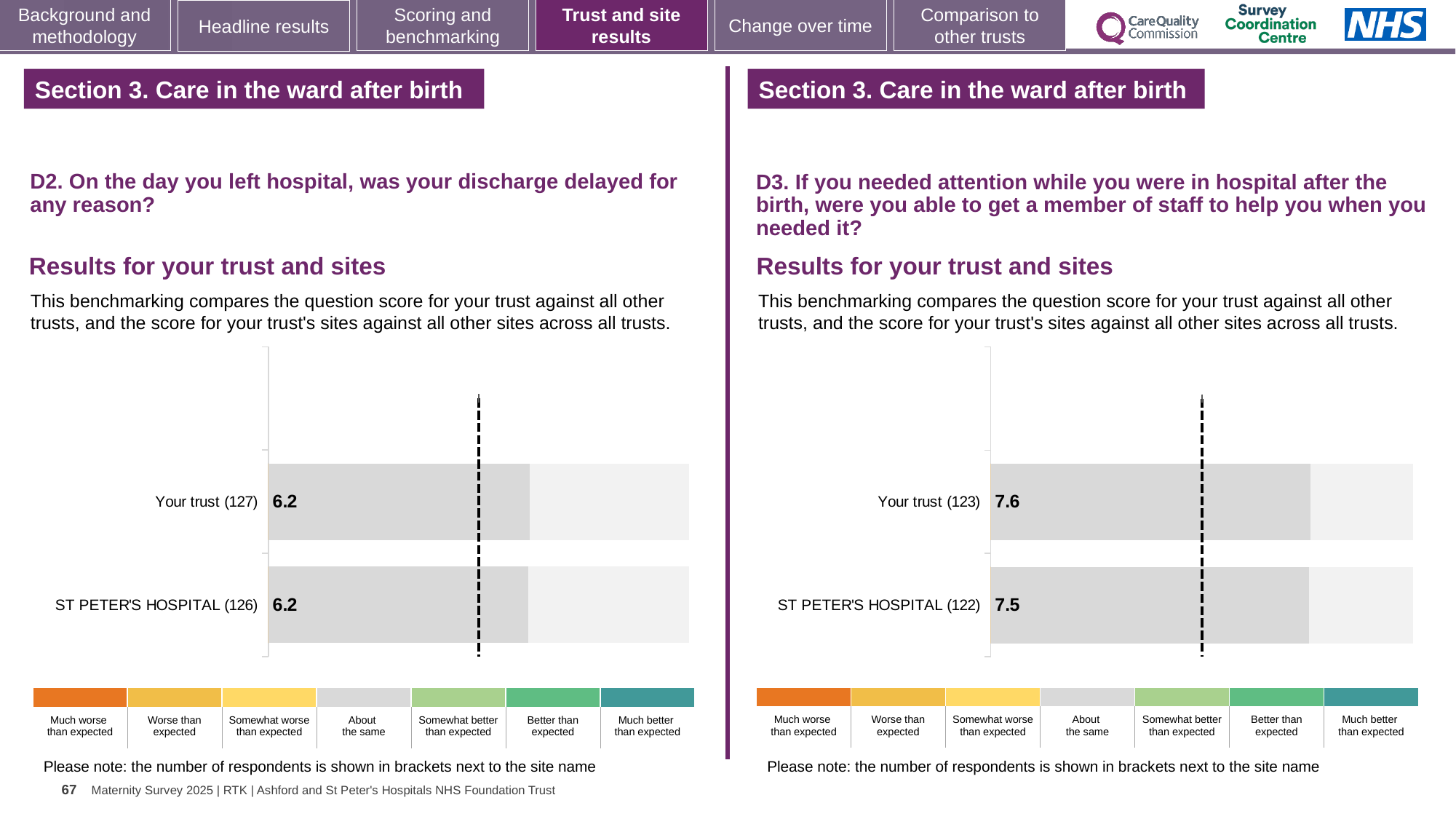
In the right chart (D3), how many respondents are shown in brackets for Your trust? 123 In the left chart (D2, discharge delayed), what is the score for ST PETER'S HOSPITAL? 6.2 In the right chart (D3, able to get a member of staff to help), what is the score for ST PETER'S HOSPITAL? 7.5 In the right chart (D3), what is the difference between the score for Your trust and the score for ST PETER'S HOSPITAL? 0.1 How many bars are plotted in the left chart (D2)? 2 In the left chart (D2), how many respondents are shown in brackets for ST PETER'S HOSPITAL? 126 How many bars are plotted in the right chart (D3)? 2 In the left chart (D2, discharge delayed), what is the score for Your trust? 6.2 In the right chart (D3), which has the higher score, Your trust or ST PETER'S HOSPITAL? Your trust In the left chart (D2), what is the difference between the score for Your trust and the score for ST PETER'S HOSPITAL? 0 What type of chart is used on the left (D2)? Bar chart In the right chart (D3, able to get a member of staff to help), what is the score for Your trust? 7.6